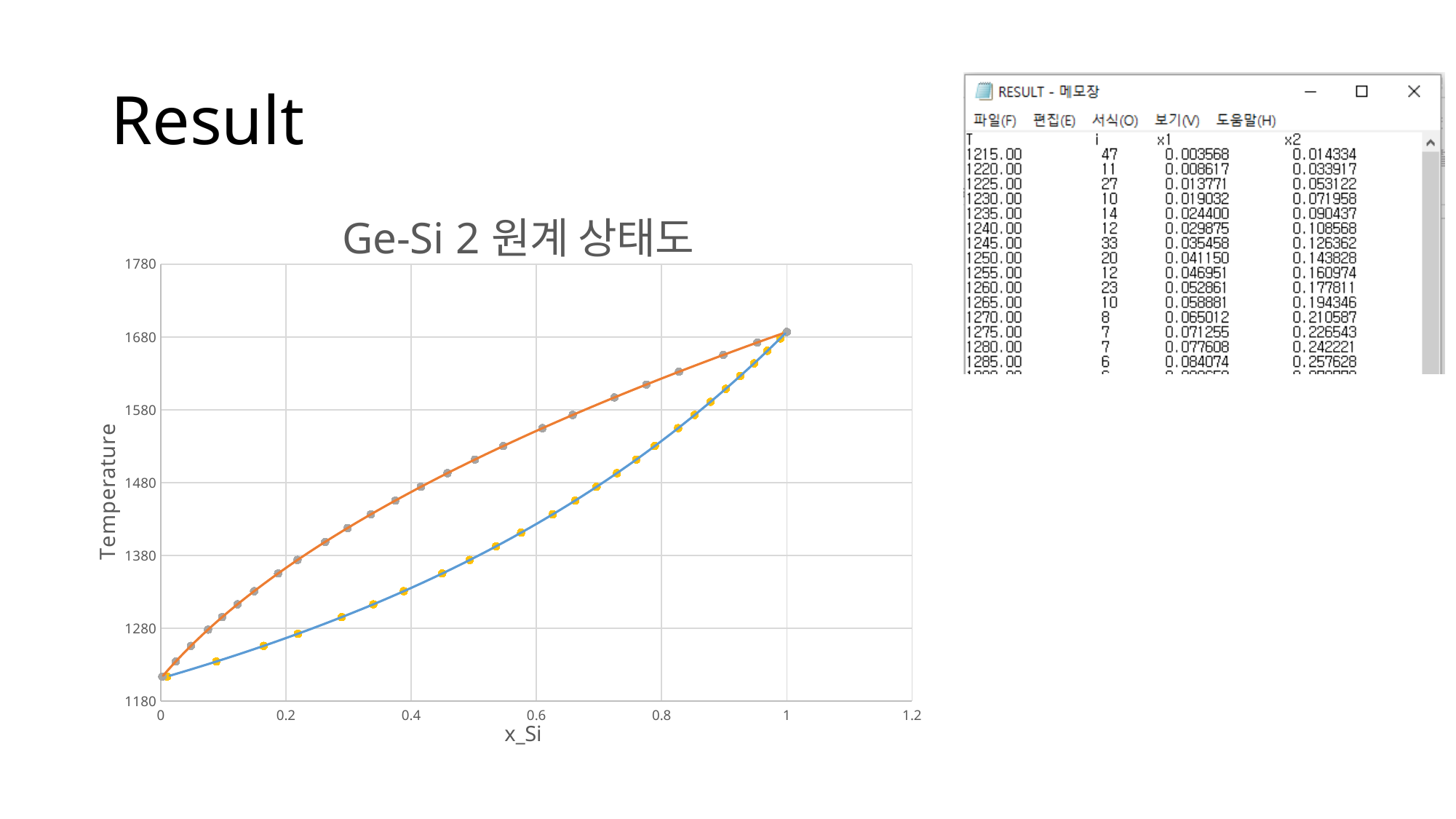
Is the temperature of the orange curve at x_Si = 0.8 greater or less than 1580? greater Is the temperature of the orange curve at x_Si = 0.6 greater or less than 1480? greater Is the temperature of the orange curve at x_Si = 0.2 greater or less than 1480? less Does the orange curve rise or fall as x_Si increases from 0 to 1? rise What is the title of the chart? Ge-Si 2 원계 상태도 Does the blue curve rise or fall as x_Si increases from 0 to 1? rise What is the label of the x axis of the chart? x_Si How many curves are plotted on the chart? 2 At x_Si = 0.4, which curve has the higher temperature, the orange one or the blue one? orange What kind of chart is shown on the slide? line chart